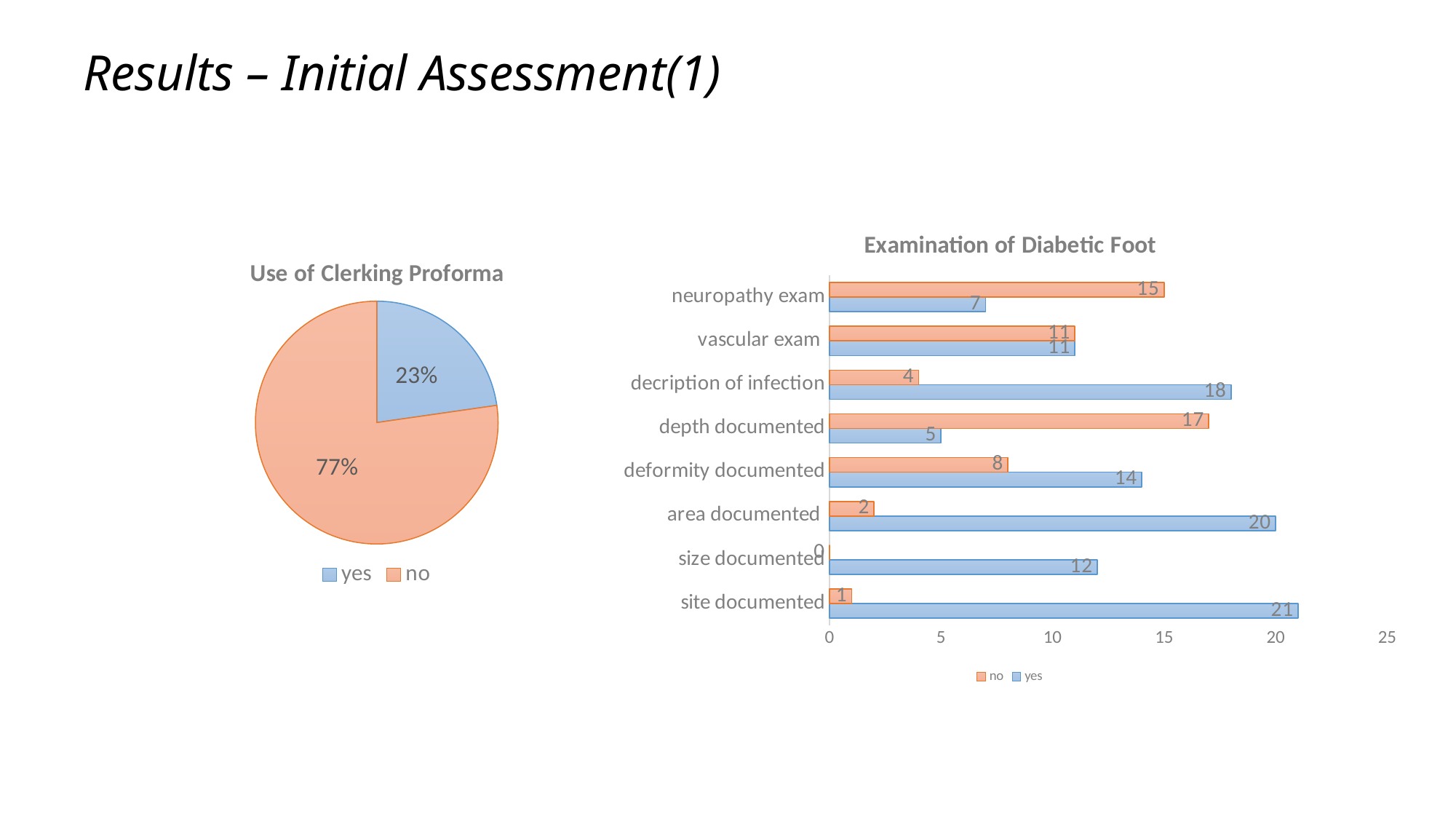
In the 'Examination of Diabetic Foot' chart, what is the 'no' value for 'neuropathy exam'? 15 How many series does the legend of the 'Examination of Diabetic Foot' chart list? 2 What kind of chart is 'Use of Clerking Proforma'? pie chart In the 'Examination of Diabetic Foot' chart, which category has the highest 'yes' value? site documented In the 'Examination of Diabetic Foot' chart, what is the difference between the 'yes' and 'no' values for 'depth documented'? 12 In the 'Examination of Diabetic Foot' chart, what is the 'yes' value for 'site documented'? 21 In the 'Use of Clerking Proforma' chart, what share of the pie is 'no'? 77% In the 'Examination of Diabetic Foot' chart, which is larger for 'deformity documented', the 'yes' value or the 'no' value? yes How many categories are shown in the 'Examination of Diabetic Foot' chart? 8 In the 'Examination of Diabetic Foot' chart, which category has the lowest 'no' value? size documented In the 'Use of Clerking Proforma' chart, what share of the pie is 'yes'? 23% What kind of chart is 'Examination of Diabetic Foot'? bar chart